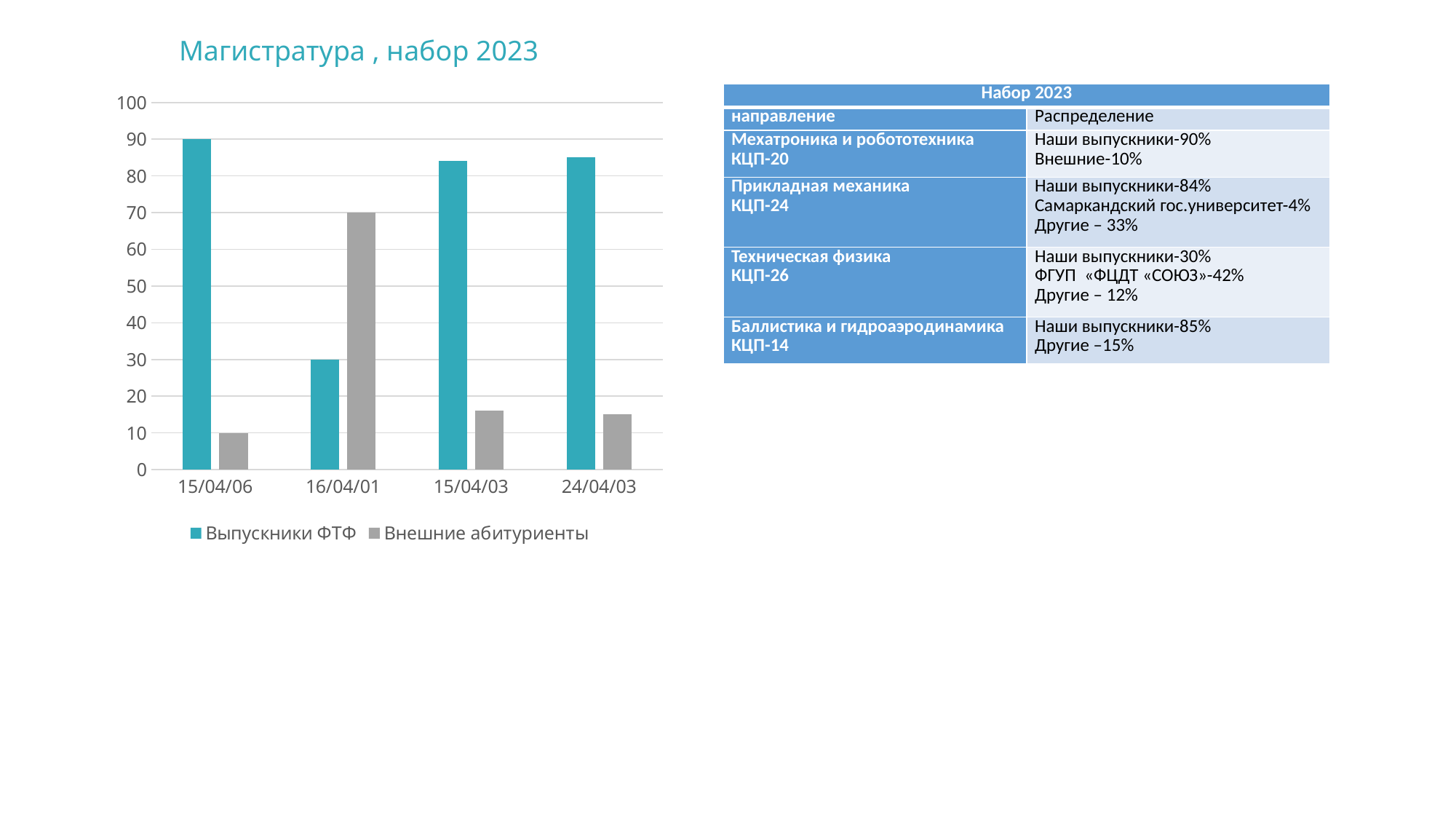
What kind of chart is shown on the slide? bar chart What is the value for Внешние абитуриенты at 16/04/01? 70 How many series does the chart legend list? 2 How many categories are shown on the x axis of the chart? 4 Which category has the highest value for Выпускники ФТФ? 15/04/06 What is the value for Выпускники ФТФ at 15/04/06? 90 What is the value for Внешние абитуриенты at 15/04/06? 10 What is the value for Выпускники ФТФ at 16/04/01? 30 Is the value for Выпускники ФТФ at 15/04/03 greater or less than 80? greater At 16/04/01, which series has the larger value, Выпускники ФТФ or Внешние абитуриенты? Внешние абитуриенты Is the value for Внешние абитуриенты at 24/04/03 greater or less than 20? less Which category has the lowest value for Выпускники ФТФ? 16/04/01